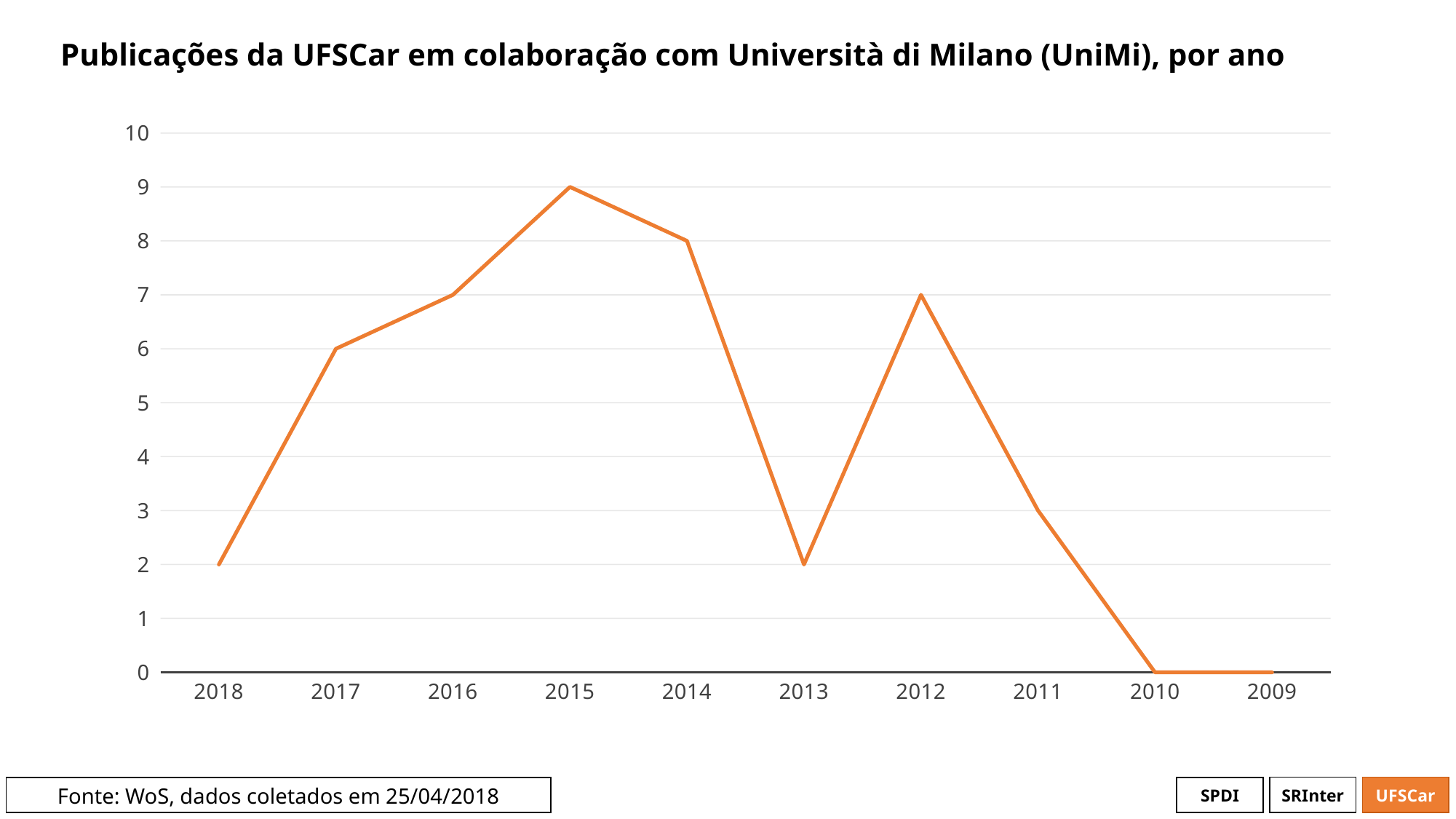
Which year has the highest value? 2015 What is the value for 2018? 2 What is the difference between the values for 2015 and 2014? 1 What is the value for 2015? 9 What is the value for 2010? 0 What is the title of the chart? Publicações da UFSCar em colaboração com Università di Milano (UniMi), por ano Is the value for 2014 greater or less than 5? greater What kind of chart is shown on the slide? line chart Which is larger, the value for 2016 or the value for 2011? 2016 What is the value for 2012? 7 How many years are plotted on the x axis? 10 What is the difference between the values for 2017 and 2013? 4